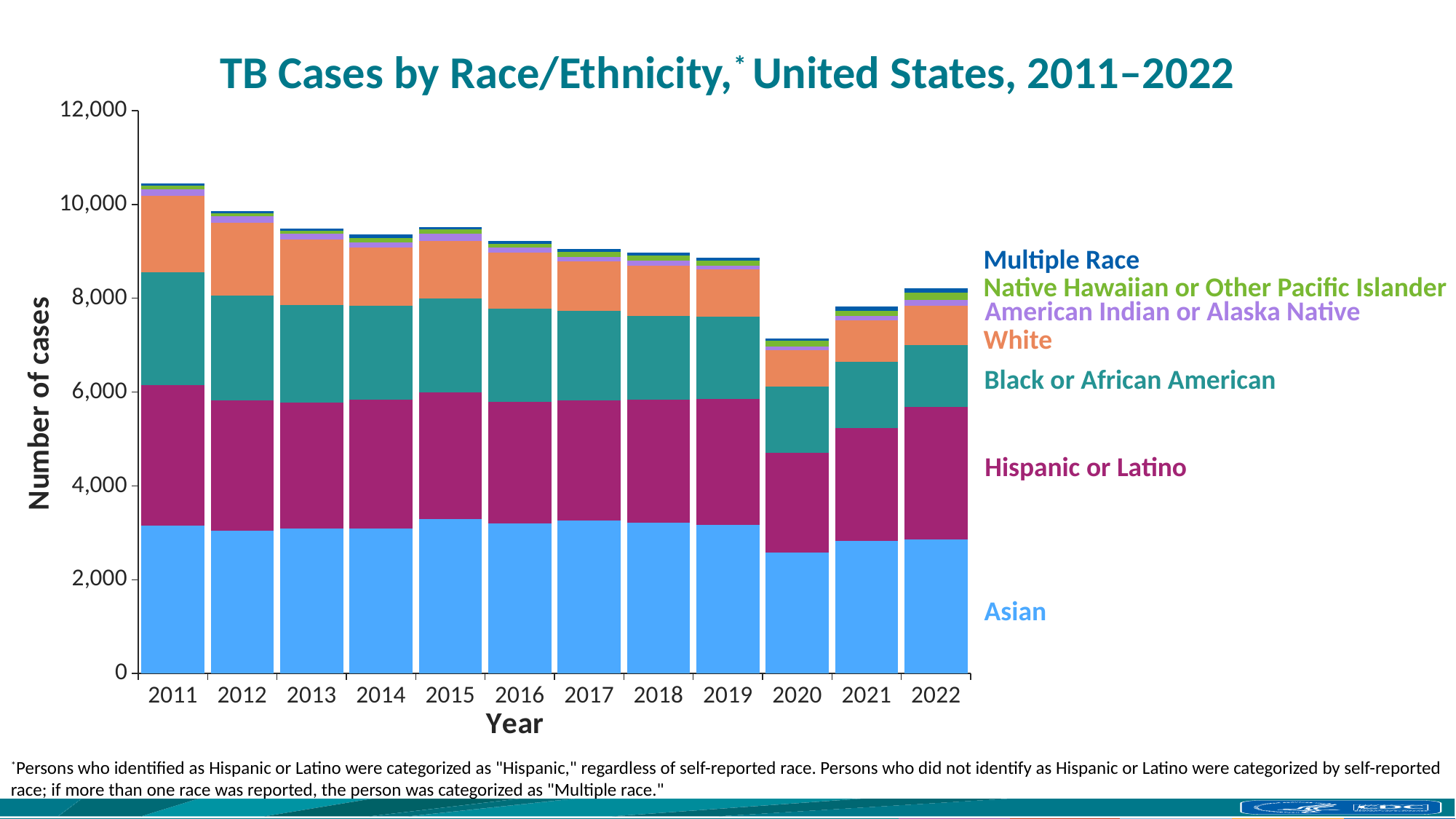
Is the total number of TB cases in 2020 greater or less than 8,000? less What kind of chart is shown on the slide? Stacked bar chart How many race/ethnicity series does the legend list? 7 Which year has a larger total number of TB cases, 2019 or 2020? 2019 Do total TB cases generally rise or fall from 2011 to 2020? fall Which year has the lowest total number of TB cases? 2020 Which race/ethnicity series forms the bottom segment of each stacked bar? Asian What is the title of the chart? TB Cases by Race/Ethnicity, United States, 2011–2022 Is the number of Asian TB cases in 2020 greater or less than 3,000? less How many years are shown along the x axis? 12 Which year has the highest total number of TB cases? 2011 Is the total number of TB cases in 2011 greater or less than 10,000? greater